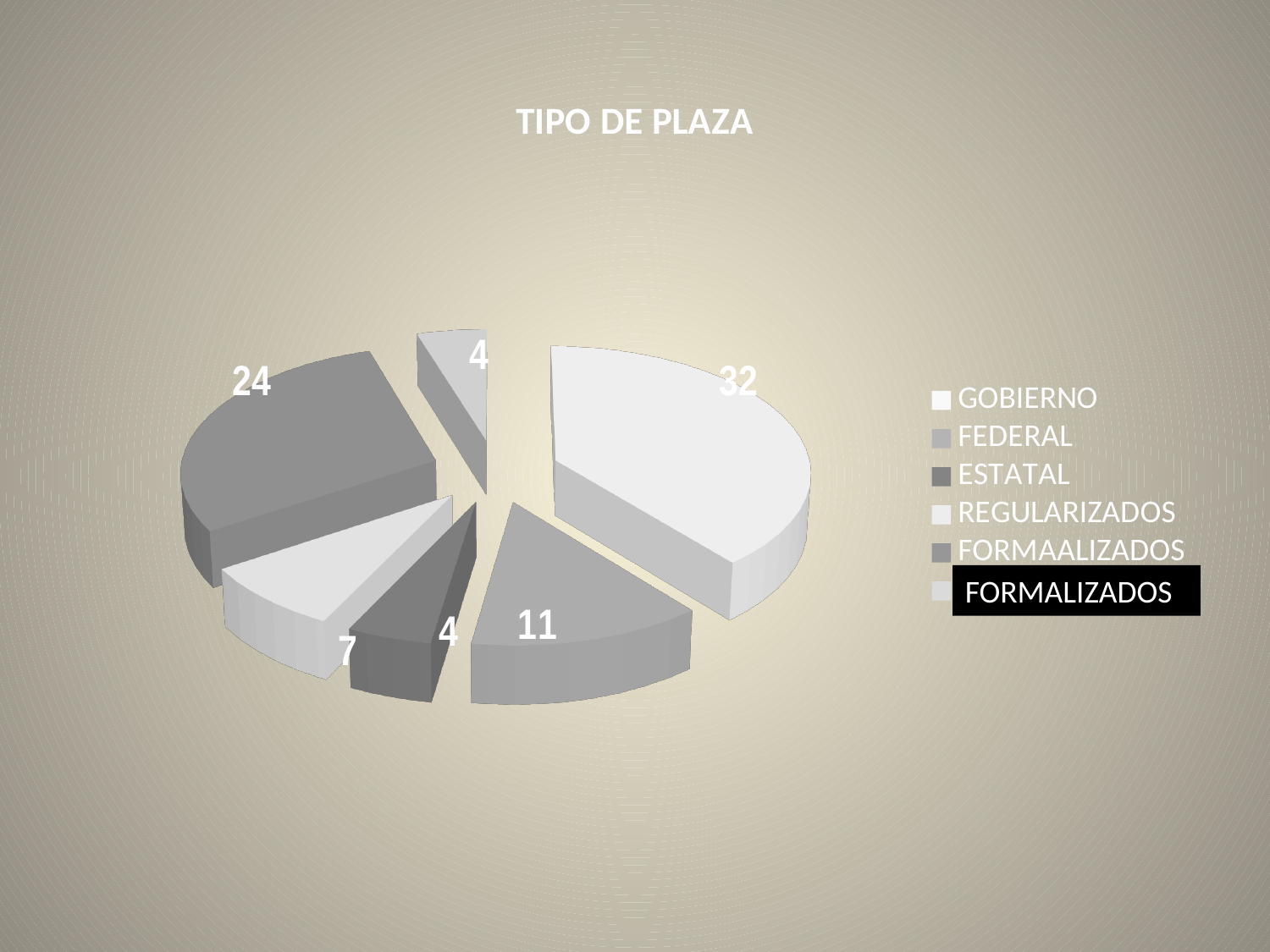
What is the value of the FEDERAL slice? 11 What is the value of the REGULARIZADOS slice? 7 How many entries does the legend list? 6 Which is larger, the FEDERAL slice or the REGULARIZADOS slice? FEDERAL What type of chart is shown on the slide? pie chart What is the value of the FORMAALIZADOS slice? 24 What is the value of the GOBIERNO slice? 32 What is the smallest value shown on any slice? 4 How many slices does the pie chart have? 6 Which category has the largest slice? GOBIERNO What is the title of the chart? TIPO DE PLAZA What is the difference between the GOBIERNO and FORMAALIZADOS values? 8